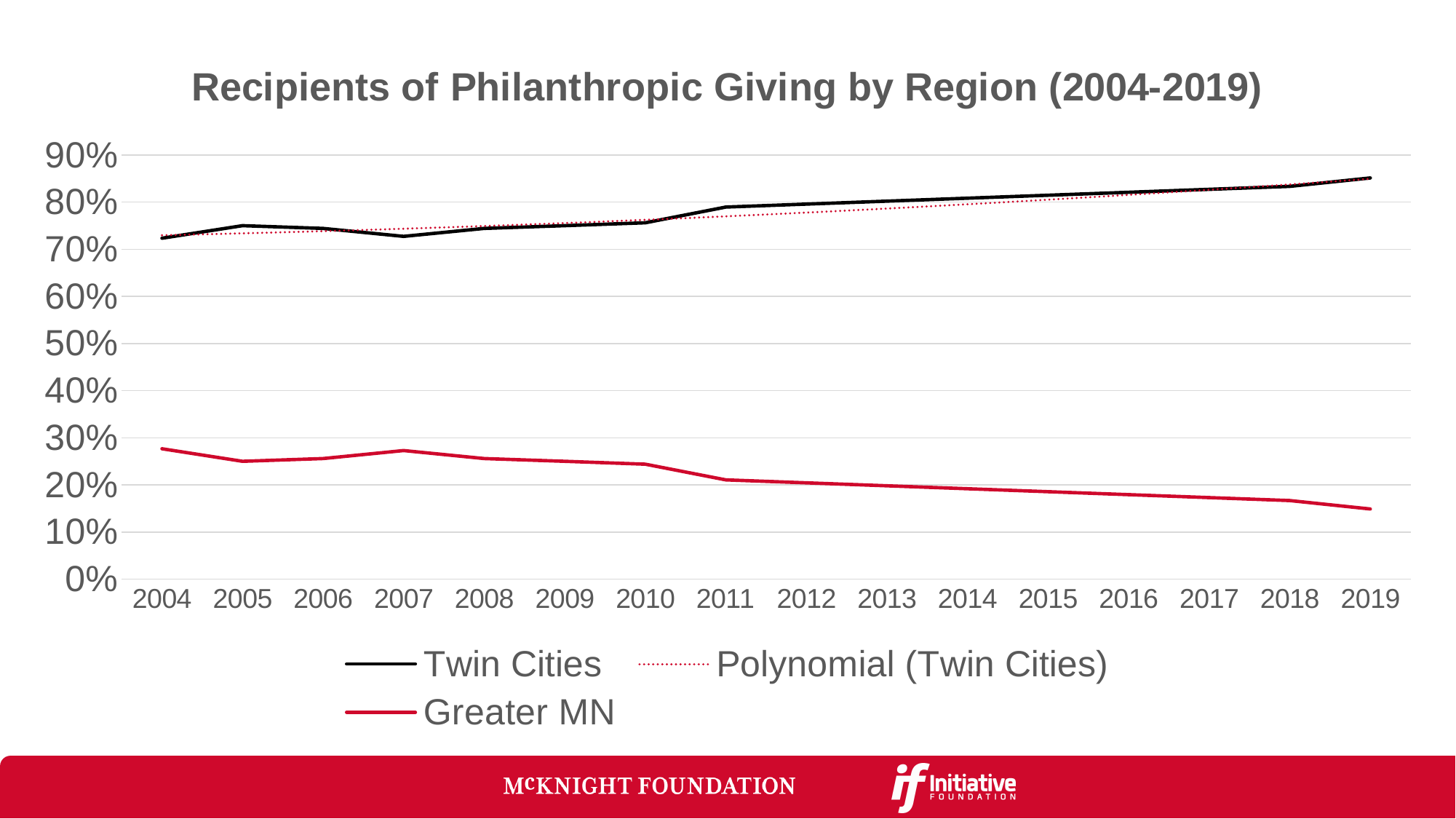
Does the Greater MN line rise or fall from 2004 to 2019? fall Is the value for Twin Cities in 2019 greater or less than 80%? greater Is the value for Greater MN in 2019 greater or less than 20%? less In which year is the Twin Cities value highest? 2019 In 2010, which series has the larger value, Twin Cities or Greater MN? Twin Cities What kind of chart is shown on the slide? line chart Is the value for Greater MN in 2004 greater or less than 20%? greater How many years are shown on the x axis? 16 How many series does the legend list? 3 Does the Twin Cities line rise or fall from 2004 to 2019? rise What is the title of the chart? Recipients of Philanthropic Giving by Region (2004-2019)